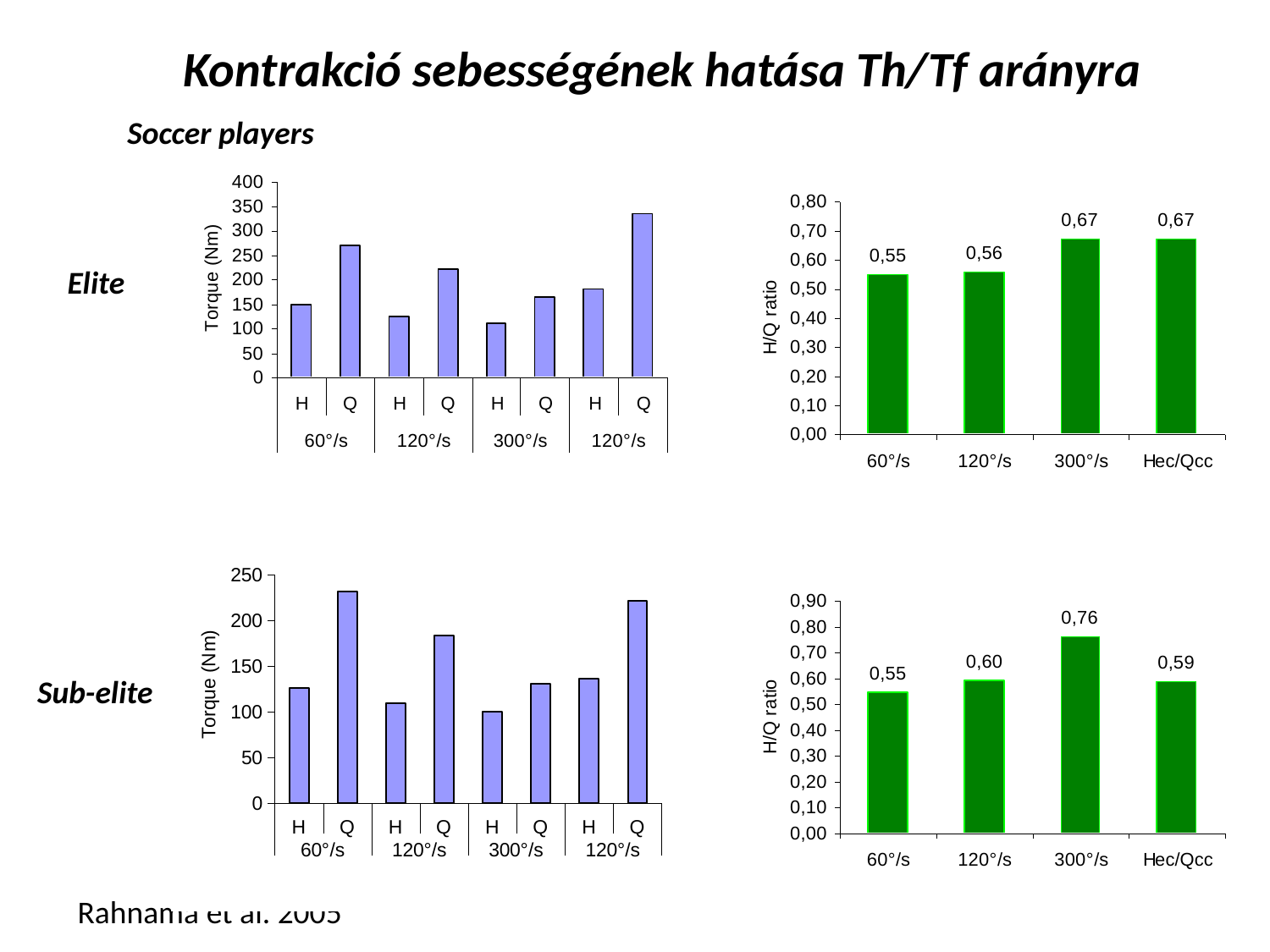
In the Sub-elite torque chart (bottom left), is the H bar at 300°/s greater or less than 150? less In the Elite H/Q ratio chart (top right), what is the difference between the values at 300°/s and 120°/s? 0,11 In the Elite torque chart (top left), is the Q bar at 60°/s greater or less than 250? greater In the Elite H/Q ratio chart (top right), which is larger, the value at 60°/s or at 120°/s? 120°/s How many bars are plotted in the Elite H/Q ratio chart (top right)? 4 In the Sub-elite H/Q ratio chart (bottom right), which category has the lowest H/Q ratio? 60°/s In the Sub-elite H/Q ratio chart (bottom right), what is the difference between the values at 300°/s and 60°/s? 0,21 In the Sub-elite H/Q ratio chart (bottom right), do the values rise or fall from 60°/s to 300°/s? rise In the Elite H/Q ratio chart (top right), what is the value for Hec/Qcc? 0,67 In the Sub-elite H/Q ratio chart (bottom right), what is the H/Q ratio at 300°/s? 0,76 In the Elite H/Q ratio chart (top right), what is the H/Q ratio at 300°/s? 0,67 In the Sub-elite H/Q ratio chart (bottom right), which category has the highest H/Q ratio? 300°/s